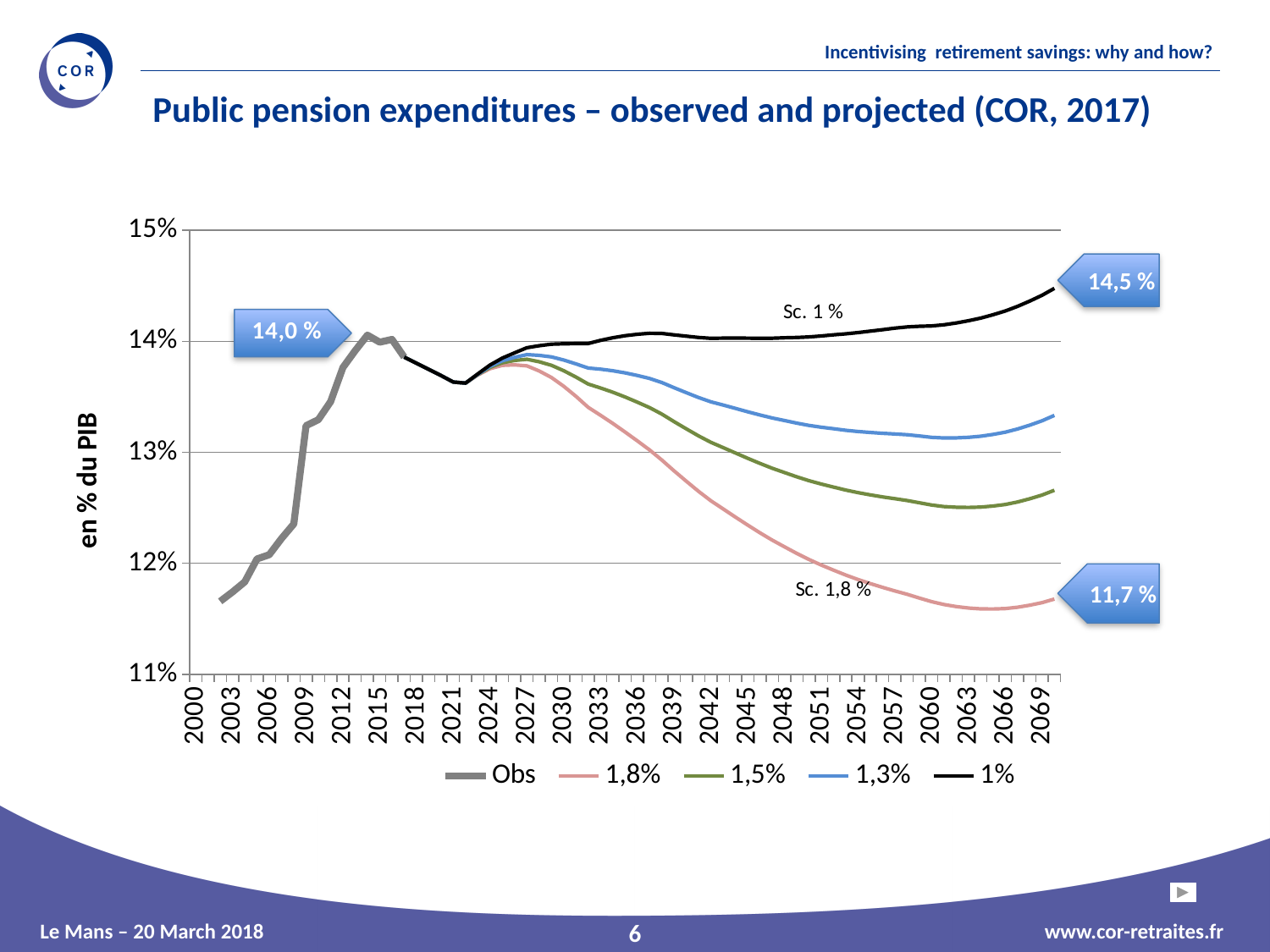
What value is labelled at the peak of the observed (Obs) series around 2014? 14,0 % What value is labelled at the end of the 1% scenario line (Sc. 1 %)? 14,5 % Does the 1,8% scenario line rise or fall between 2030 and 2060? fall Is the value of the 1,3% scenario in 2069 greater or less than 13%? greater Which scenario line ends lowest in 2070? 1,8% What is the difference between the labelled end values of the 1% scenario (14,5 %) and the 1,8% scenario (11,7 %)? 2,8 percentage points What kind of chart is shown on the slide? line chart How many series does the legend list? 5 Is the value of the Obs series in 2002 greater or less than 12%? less What value is labelled at the end of the 1,8% scenario line (Sc. 1,8 %)? 11,7 % In 2069, which is higher: the 1,3% scenario or the 1,5% scenario? 1,3% Which scenario line ends highest in 2070? 1%